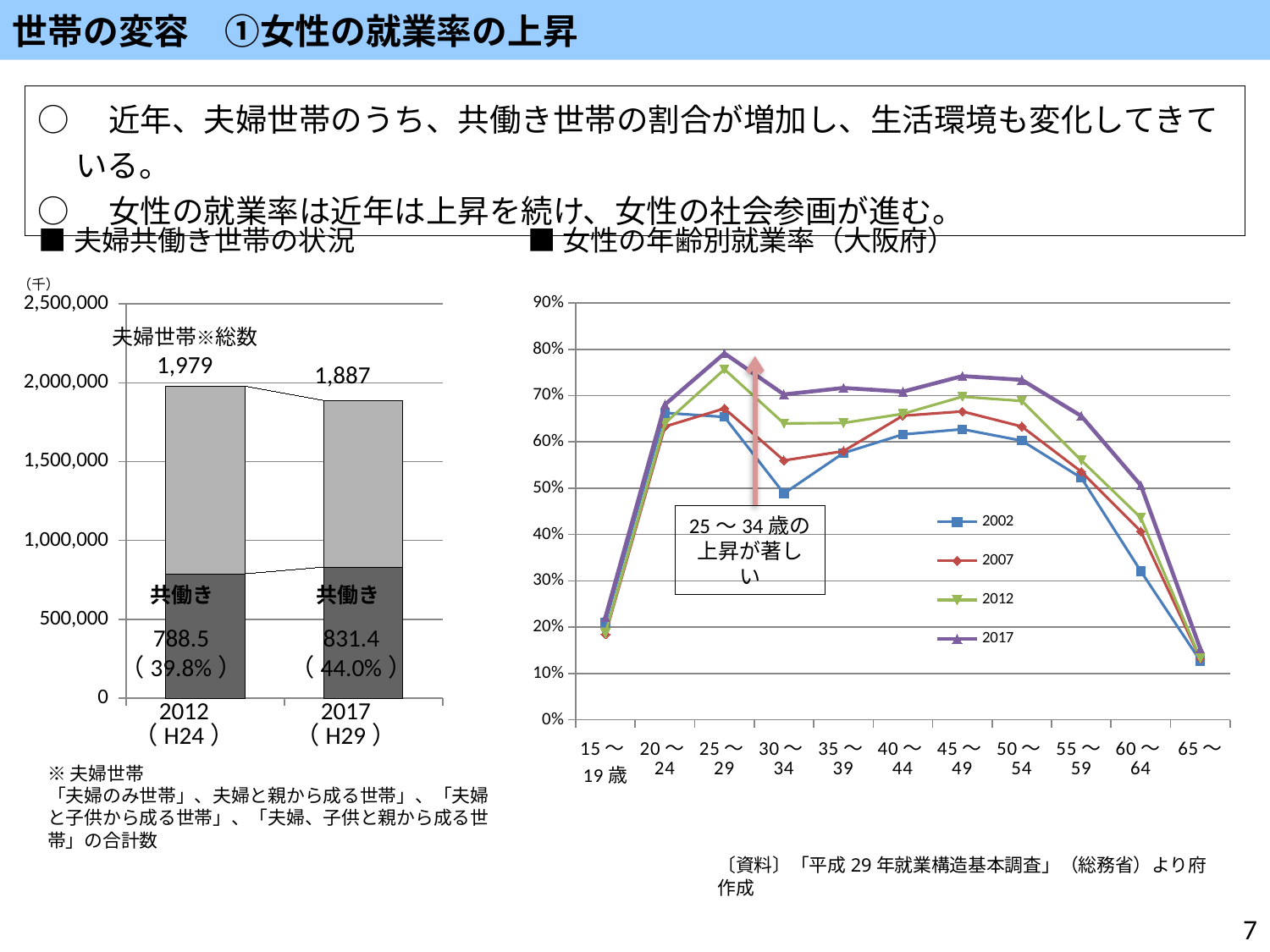
In the left chart (夫婦共働き世帯の状況), what is the 共働き value shown for 2017 (H29)? 831.4 In the left chart (夫婦共働き世帯の状況), what is the difference between the 夫婦世帯※総数 values for 2012 and 2017? 92 What kind of chart is the left chart (夫婦共働き世帯の状況)? Bar chart In the right chart (女性の年齢別就業率（大阪府）), how many age groups are shown on the x axis? 11 In the right chart (女性の年齢別就業率（大阪府）), which series has the larger value at 30〜34, 2002 or 2017? 2017 In the left chart (夫婦共働き世帯の状況), which year has the larger 共働き value, 2012 or 2017? 2017 In the right chart (女性の年齢別就業率（大阪府）), is the 2017 value for 25〜29 greater or less than 70%? greater In the right chart (女性の年齢別就業率（大阪府）), which age group has the highest value for the 2017 series? 25〜29 In the left chart (夫婦共働き世帯の状況), what percentage is shown for 共働き in 2012 (H24)? 39.8% In the right chart (女性の年齢別就業率（大阪府）), how many series does the legend list? 4 In the left chart (夫婦共働き世帯の状況), what is the 夫婦世帯※総数 value shown for 2012 (H24)? 1,979 In the left chart (夫婦共働き世帯の状況), how many years are shown on the x axis? 2